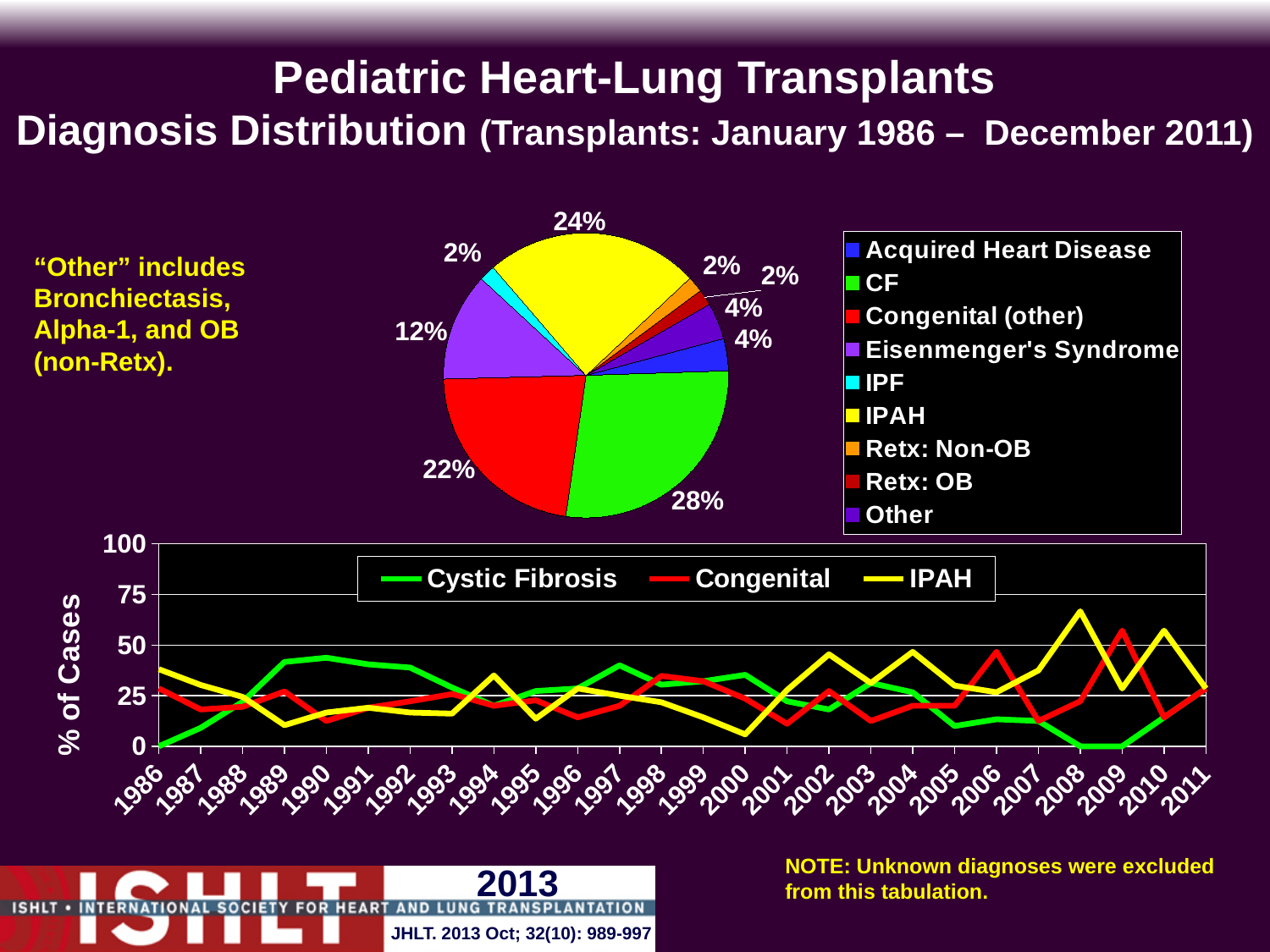
In the pie chart, what percentage of cases is IPAH? 24% In the pie chart, what is the difference in percentage points between the CF slice and the IPAH slice? 4 What kind of chart is the lower chart showing % of Cases by year? Line chart In the pie chart, which is larger, the Congenital (other) slice or the IPAH slice? IPAH In the pie chart, what percentage of cases is IPF? 2% How many diagnosis categories does the pie chart legend list? 9 In the lower line chart, in which year does the IPAH series reach its highest value? 2008 In the pie chart, which diagnosis has the largest share? CF In the pie chart, what percentage of cases is CF? 28% In the pie chart, what percentage of cases is Congenital (other)? 22% In the lower line chart, is the IPAH value for 2008 greater or less than 50? greater How many series does the legend of the lower line chart list? 3